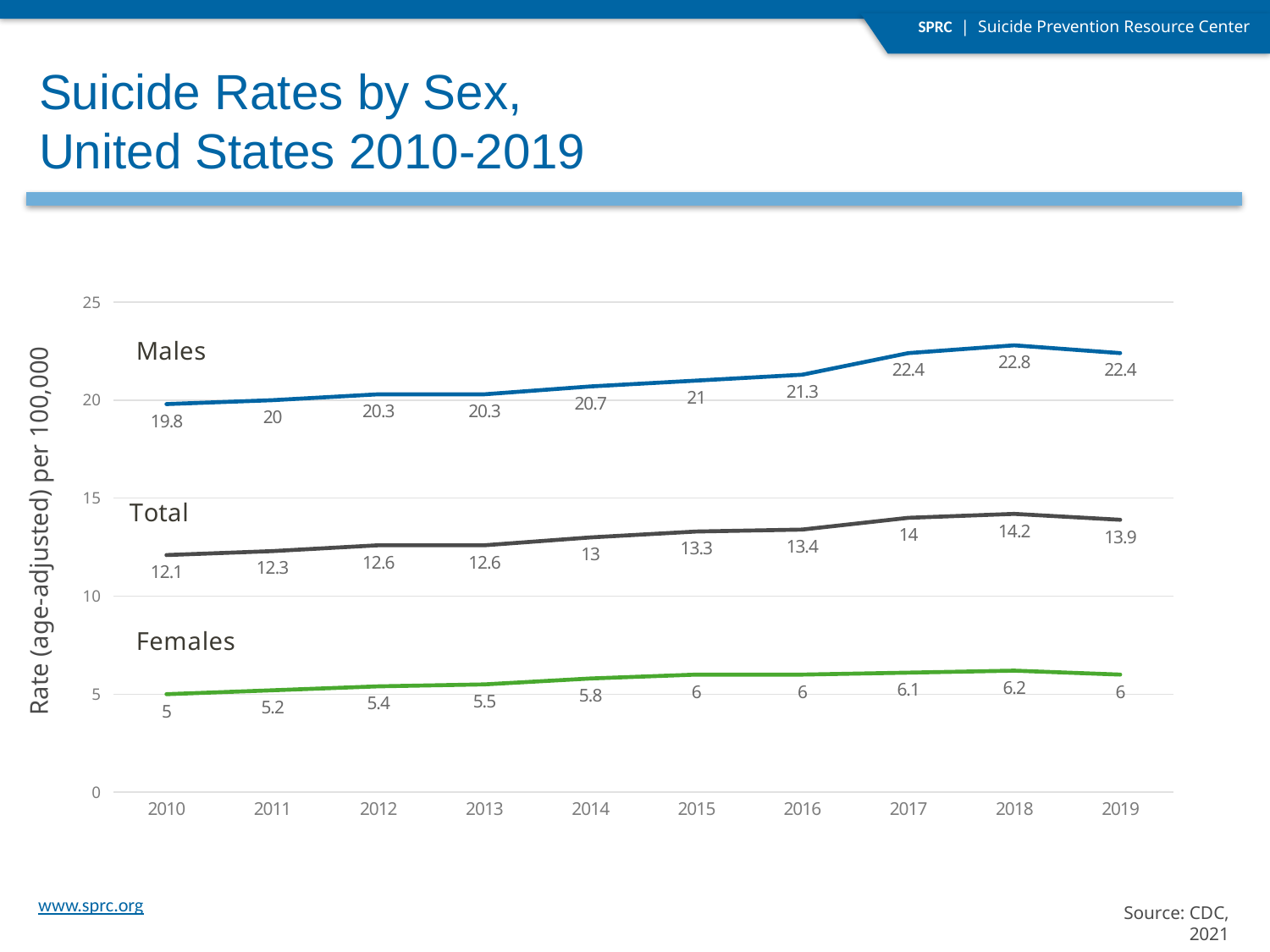
What is the difference between the Males rate and the Females rate in 2019? 16.4 What was the Total suicide rate in 2019? 13.9 What is the label of the y axis? Rate (age-adjusted) per 100,000 How many years are shown on the x axis? 10 What was the suicide rate for Males in 2018? 22.8 In which year was the Females suicide rate lowest? 2010 Which was higher in 2016, the Total rate or the Females rate? Total Is the Males rate in 2017 greater or less than 20? greater What was the suicide rate for Females in 2010? 5 In which year was the Males suicide rate highest? 2018 How many series are plotted on the chart? 3 What kind of chart is shown on the slide? line chart